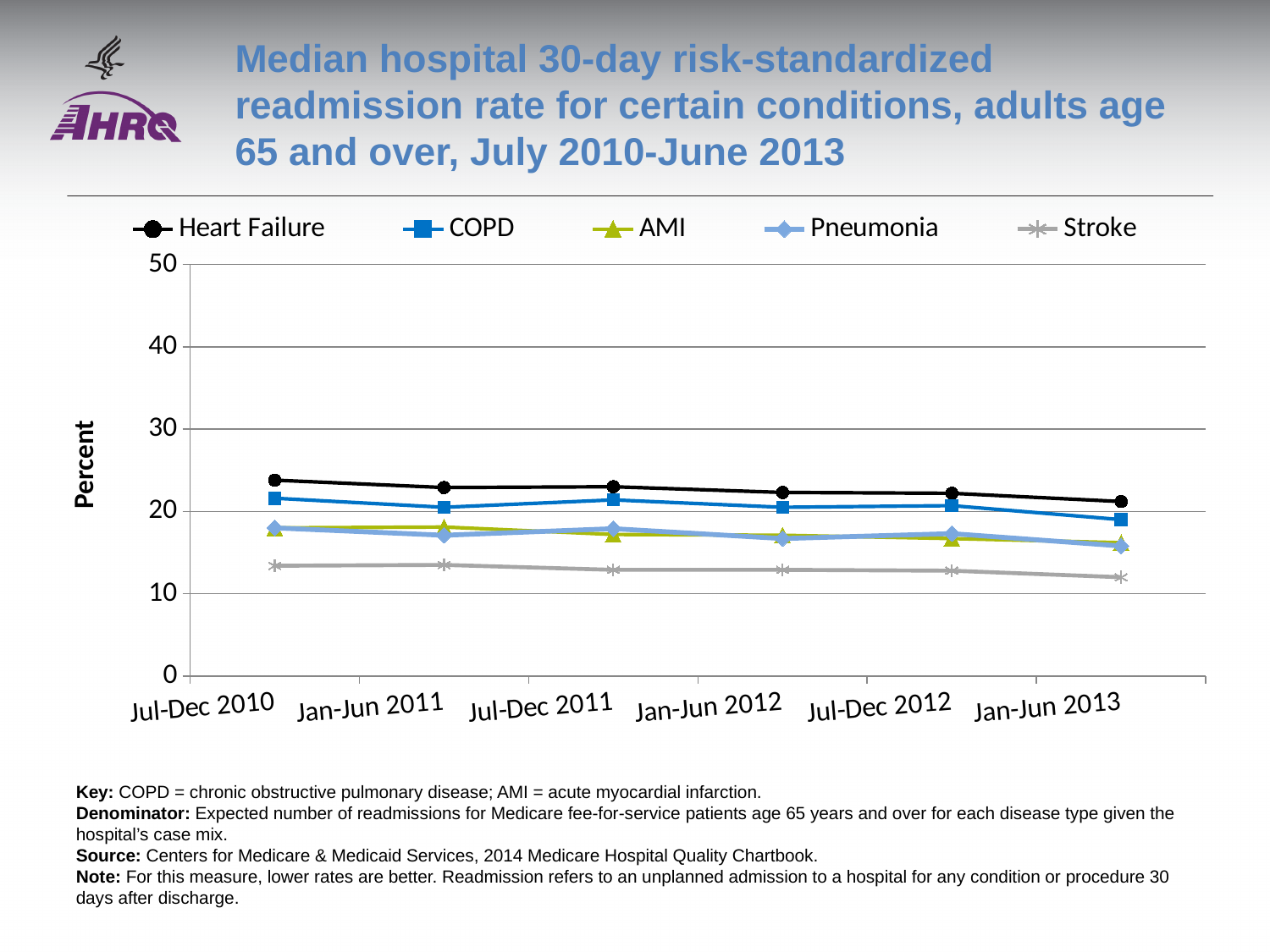
Is the Stroke value for Jan-Jun 2013 greater or less than 20? less What kind of chart is shown on the slide? Line chart Is the Heart Failure value for Jul-Dec 2010 greater or less than 20? greater How many series does the legend list? 5 How many time periods are plotted along the x axis? 6 Does the Heart Failure readmission rate rise or fall from Jul-Dec 2010 to Jan-Jun 2013? Fall Which condition has the highest median readmission rate across all periods? Heart Failure Is the Stroke value for Jul-Dec 2010 greater or less than 10? greater Which condition has the lowest median readmission rate across all periods? Stroke Which is larger in Jan-Jun 2013, the COPD rate or the Stroke rate? COPD What is the label on the y axis? Percent Which is larger in Jul-Dec 2010, the Heart Failure rate or the Stroke rate? Heart Failure